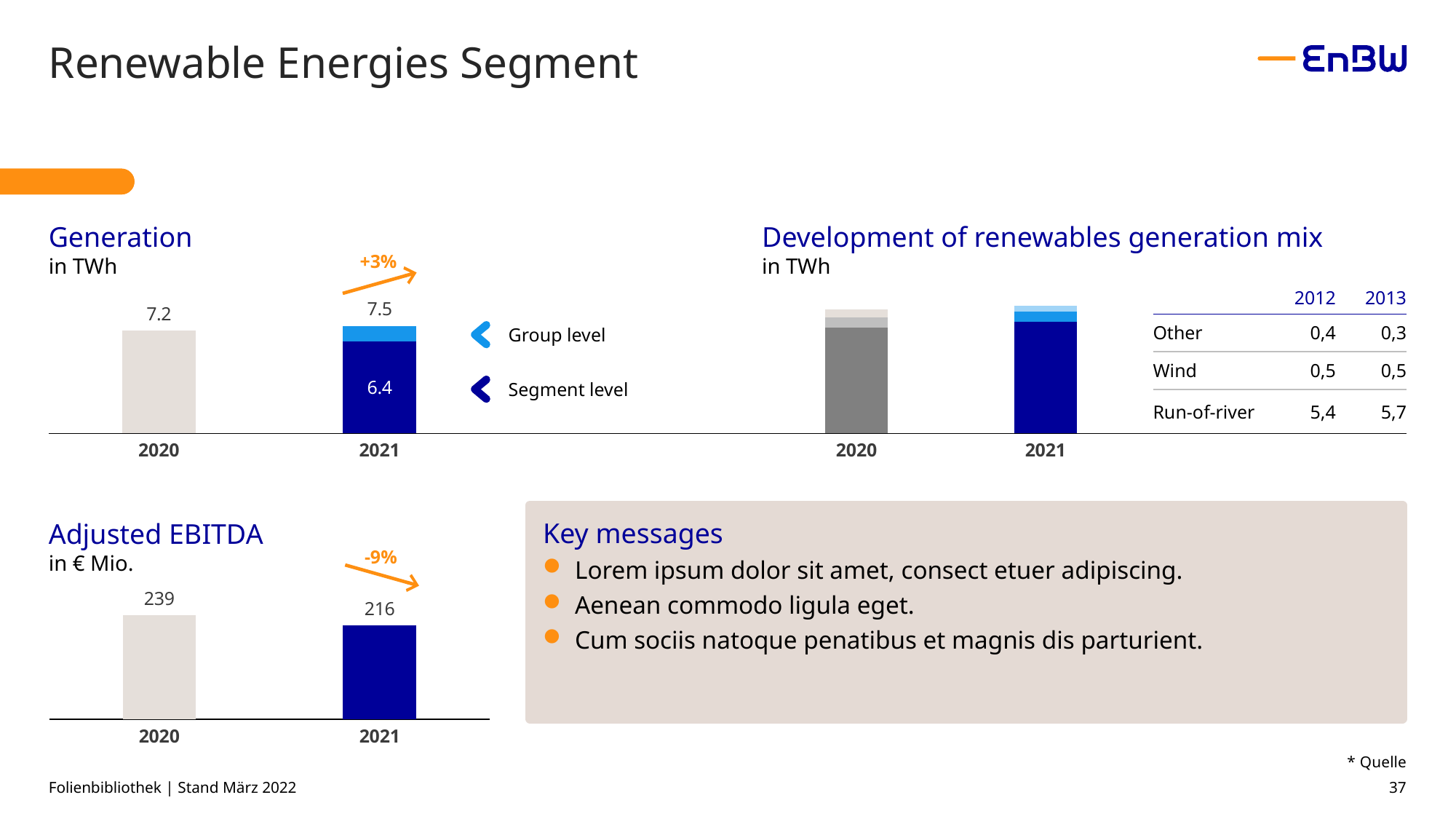
In the Adjusted EBITDA chart, what unit is stated under the title? in € Mio. In the Adjusted EBITDA chart, what is the value for 2021? 216 In the Generation chart, what percentage change is annotated between 2020 and 2021? +3% In the Generation chart, which year has the higher group level value, 2020 or 2021? 2021 In the Generation chart, what is the group level value for 2021? 7.5 In the Generation chart, what is the value for 2020? 7.2 In the Generation chart, what is the segment level value shown inside the 2021 bar? 6.4 In the table next to the Development of renewables generation mix chart, what is the Run-of-river value in the 2013 column? 5,7 In the table next to the Development of renewables generation mix chart, which row has the lowest value in the 2013 column? Other In the Adjusted EBITDA chart, what is the difference between the 2020 and 2021 values? 23 In the Adjusted EBITDA chart, what is the value for 2020? 239 In the Adjusted EBITDA chart, do the values rise or fall from 2020 to 2021? fall